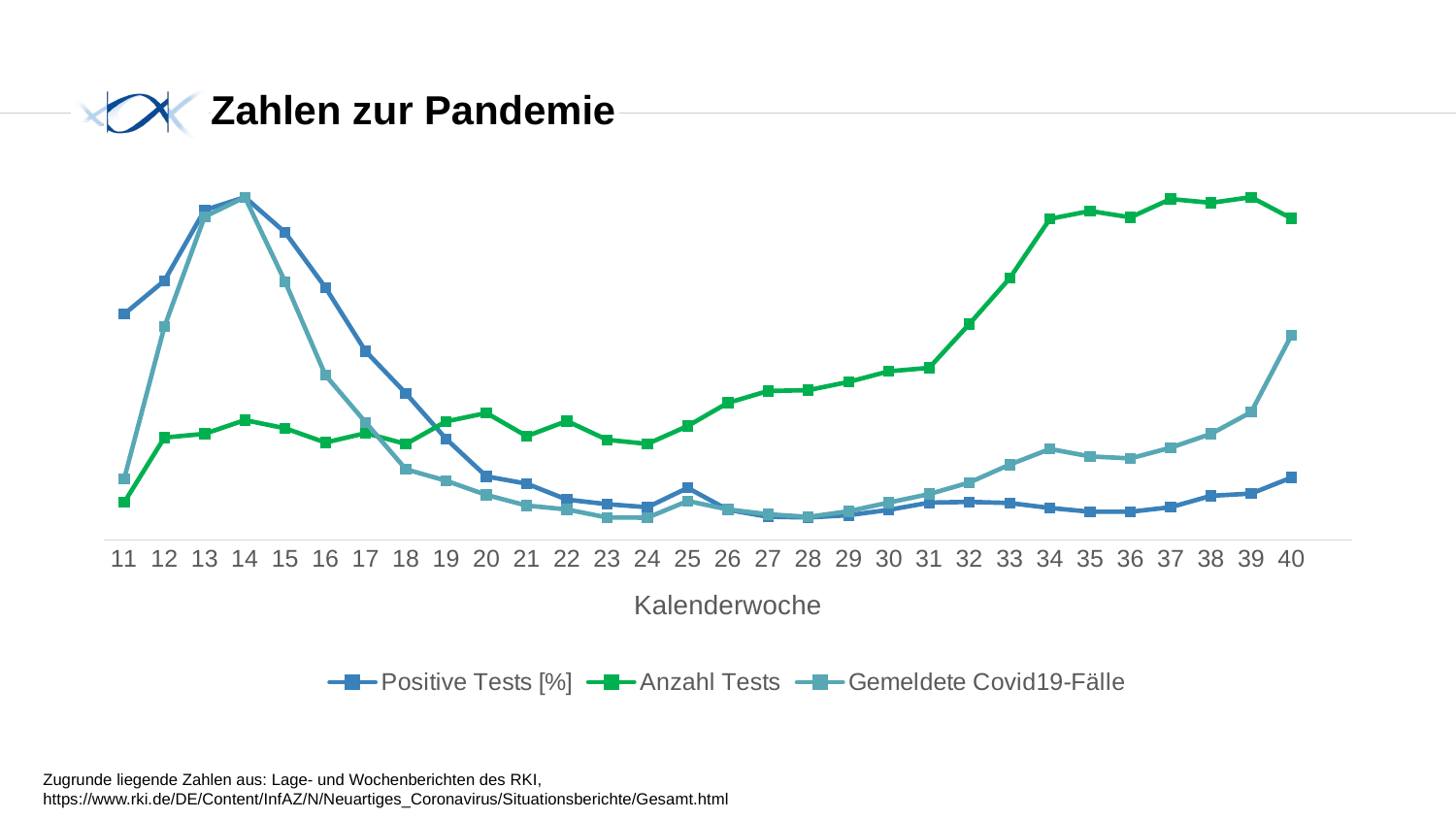
How many series does the legend list? 3 What kind of chart is shown on the slide? Line chart In calendar week 14, which series is higher: Positive Tests [%] or Anzahl Tests? Positive Tests [%] In which calendar week does the Gemeldete Covid19-Fälle series reach its highest value? 14 Does the Positive Tests [%] series rise or fall between calendar weeks 14 and 24? Fall In which calendar week is the Anzahl Tests series at its lowest? 11 What is the title of the slide containing the chart? Zahlen zur Pandemie How many calendar weeks are plotted along the x axis? 30 In calendar week 40, which series is higher: Anzahl Tests or Positive Tests [%]? Anzahl Tests What is the label of the x axis? Kalenderwoche In which calendar week does the Positive Tests [%] series reach its highest value? 14 Does the Anzahl Tests series rise or fall between calendar weeks 31 and 34? Rise